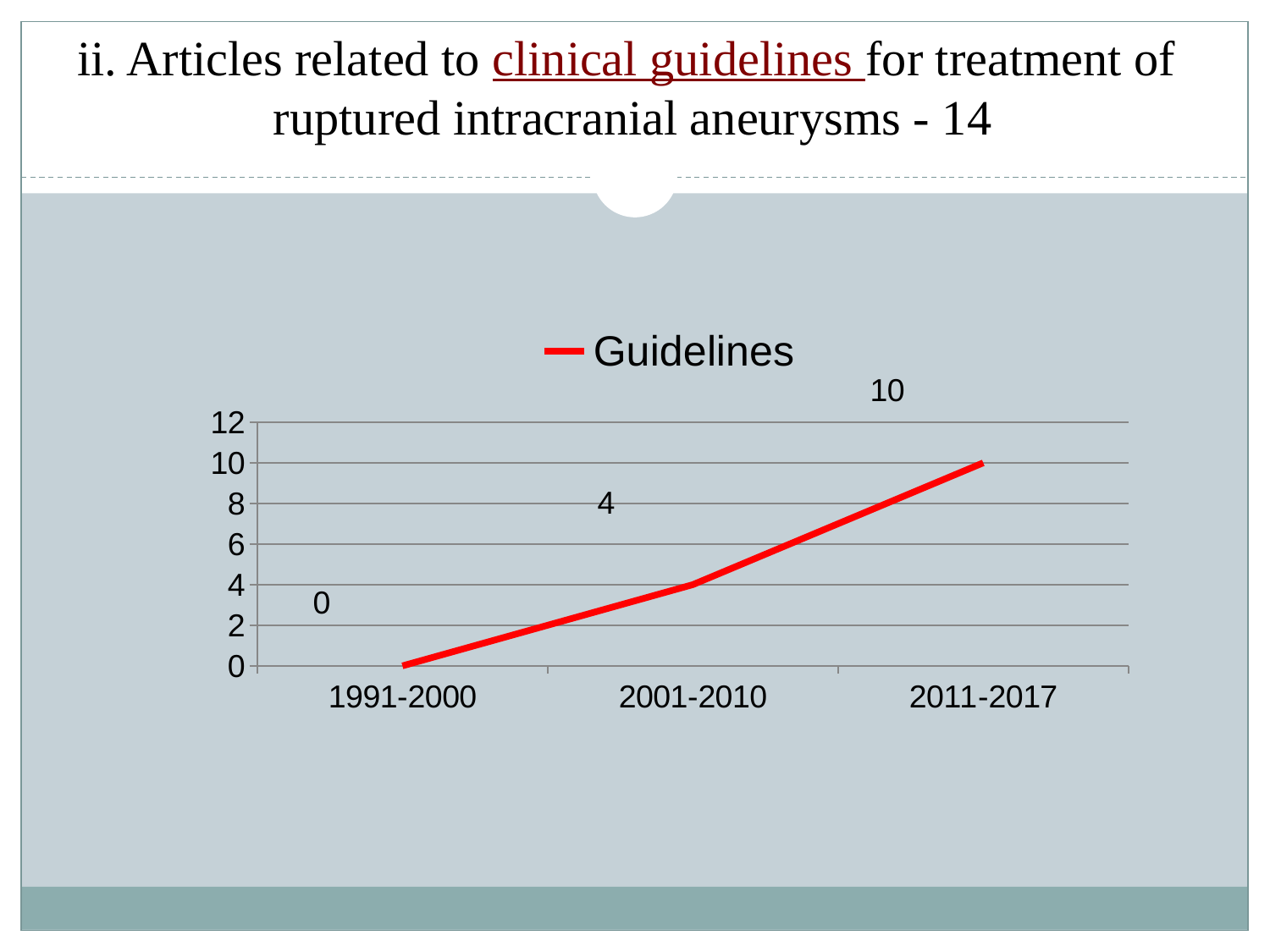
Which period has the lowest value? 1991-2000 What kind of chart is shown? line chart What is the difference between the values for 2011-2017 and 2001-2010? 6 Which period has the highest value? 2011-2017 What is the value for 1991-2000? 0 What is the value for 2001-2010? 4 Which is larger, the value for 2001-2010 or the value for 1991-2000? 2001-2010 How many series does the legend list? 1 Do the values rise or fall from 1991-2000 to 2011-2017? rise What is the value for 2011-2017? 10 Is the value for 2011-2017 greater or less than 8? greater How many periods are shown on the x axis? 3